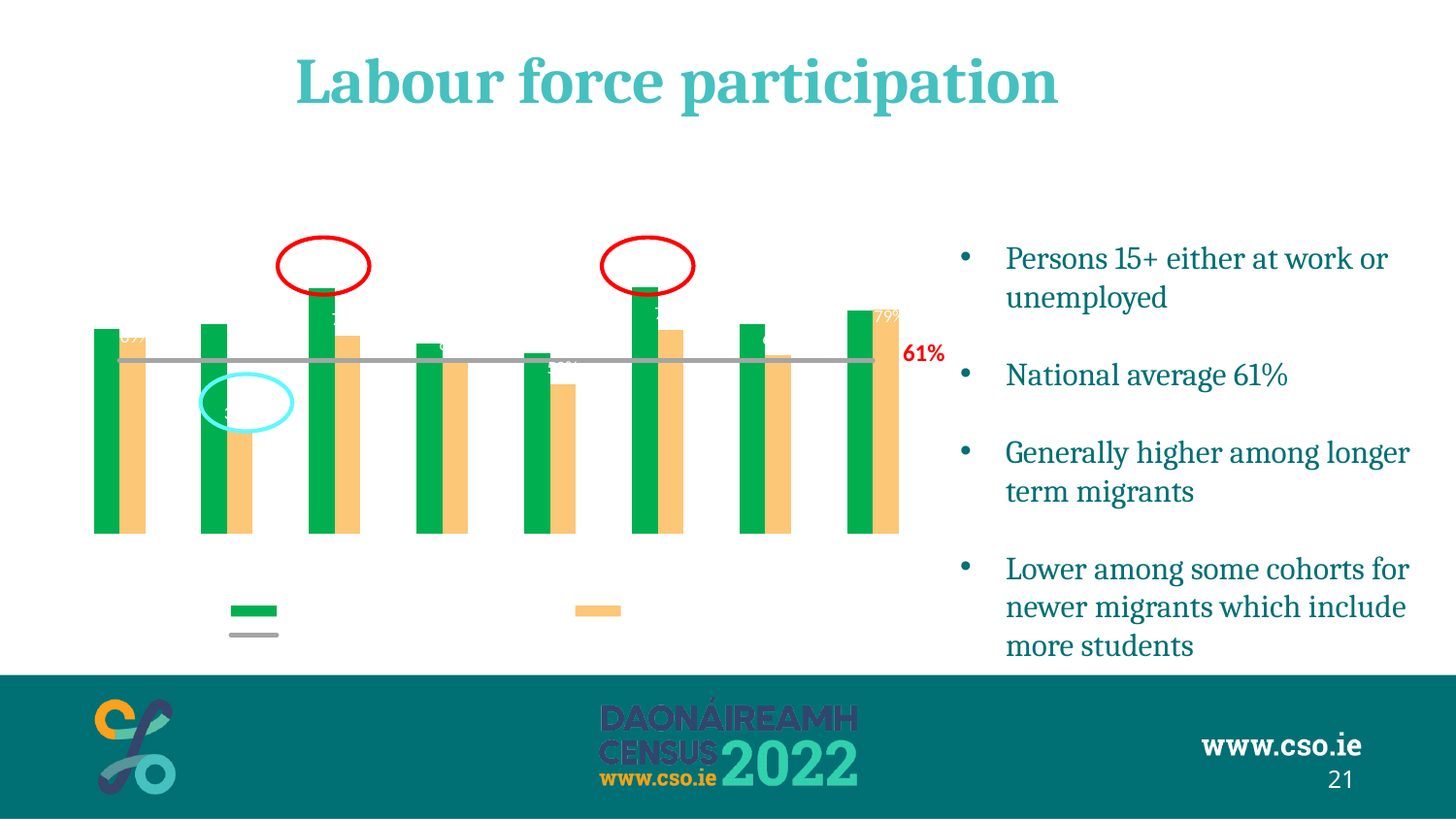
Is the green bar in the third group from the left greater or less than 61%? greater What kind of chart is shown on the slide? bar chart What is the title of the chart on the slide? Labour force participation Is the orange bar in the fifth group from the left greater or less than 61%? less Which group from the left has the lowest orange bar? the second How many groups of bars are plotted in the chart? 8 What value is labelled on the rightmost orange bar? 79% Is the orange bar in the sixth group from the left greater or less than 61%? greater What value does the horizontal grey line across the chart mark? 61% In the second group from the left, which bar is taller, the green one or the orange one? green How many entries does the chart's legend show? 3